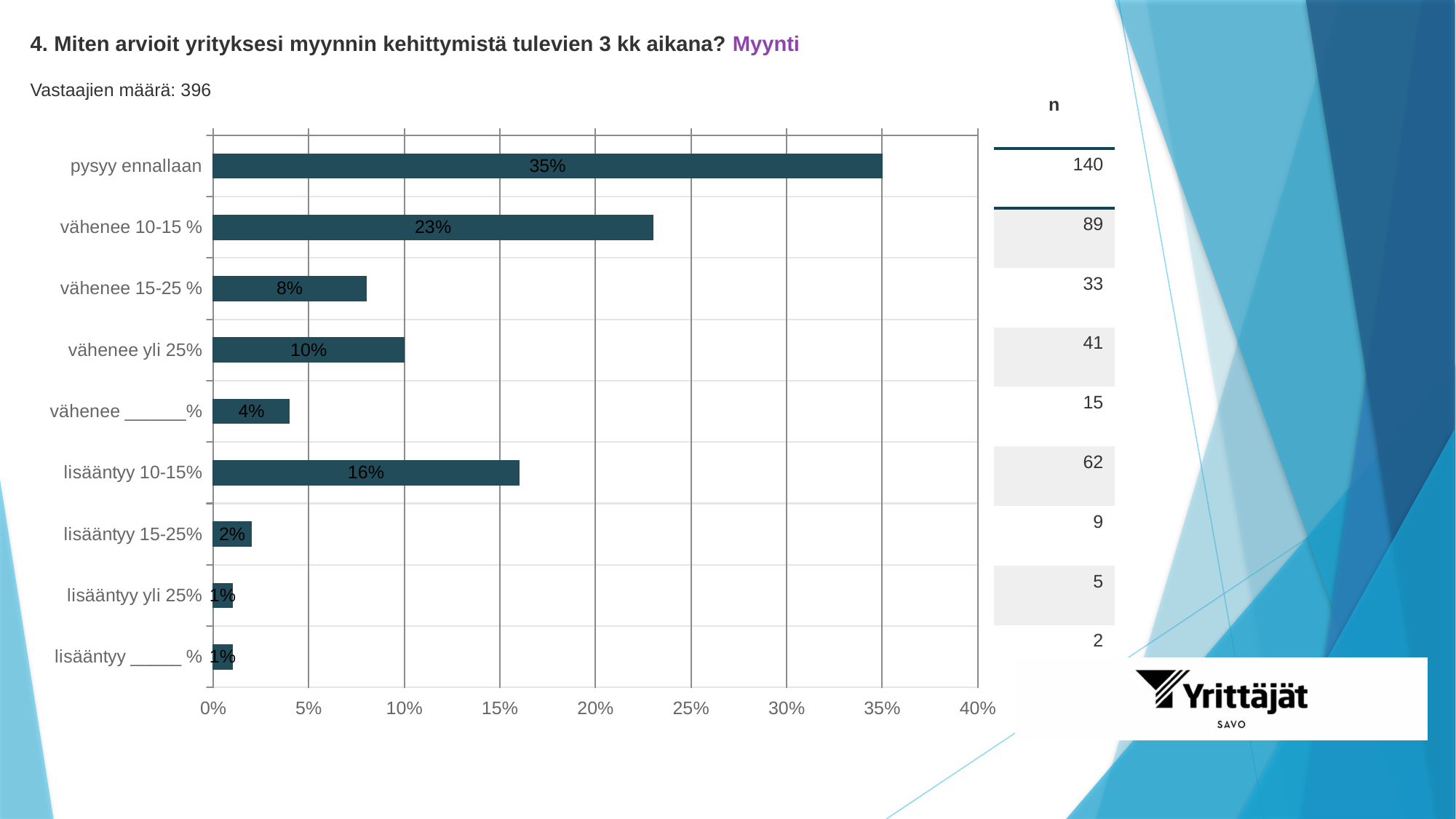
Which category has the highest percentage? pysyy ennallaan What kind of chart is shown on the slide? bar chart What is the maximum value shown on the x axis? 40% Is the value for "vähenee 10-15 %" greater or less than 20%? greater What is the value shown for "vähenee yli 25%"? 10% What percentage of respondents answered "pysyy ennallaan"? 35% What is the difference in percentage points between "pysyy ennallaan" and "vähenee 10-15 %"? 12 What percentage of respondents answered "lisääntyy 10-15%"? 16% How many categories are shown in the chart? 9 How many respondents (n) chose "vähenee 10-15 %"? 89 Which is larger, the value for "vähenee 15-25 %" or the value for "vähenee yli 25%"? vähenee yli 25% What is the total number of respondents stated on the slide? 396